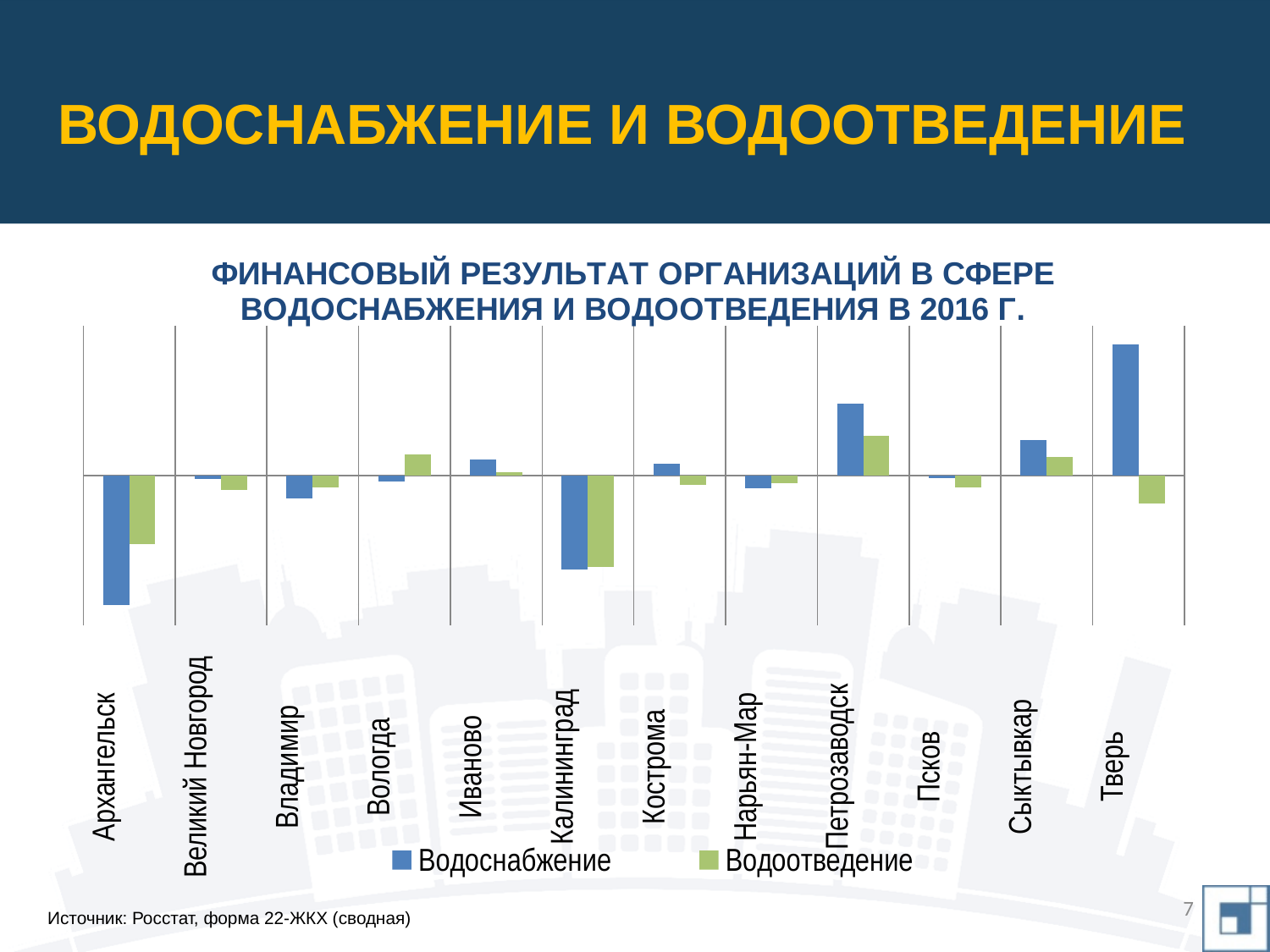
What are the two series named in the legend? Водоснабжение and Водоотведение For Водоотведение, which is larger: Вологда or Иваново? Вологда What kind of chart is shown on the slide? bar chart For Водоснабжение, which is larger: Петрозаводск or Сыктывкар? Петрозаводск Which city has the highest value for Водоснабжение? Тверь How many cities are shown on the x axis of the chart? 12 Which city has the lowest value for Водоснабжение? Архангельск How many series does the legend list? 2 Which city has the lowest value for Водоотведение? Калининград Which city has the highest value for Водоотведение? Петрозаводск For Водоснабжение, which is larger: Тверь or Петрозаводск? Тверь Which colour represents Водоотведение in the chart? green